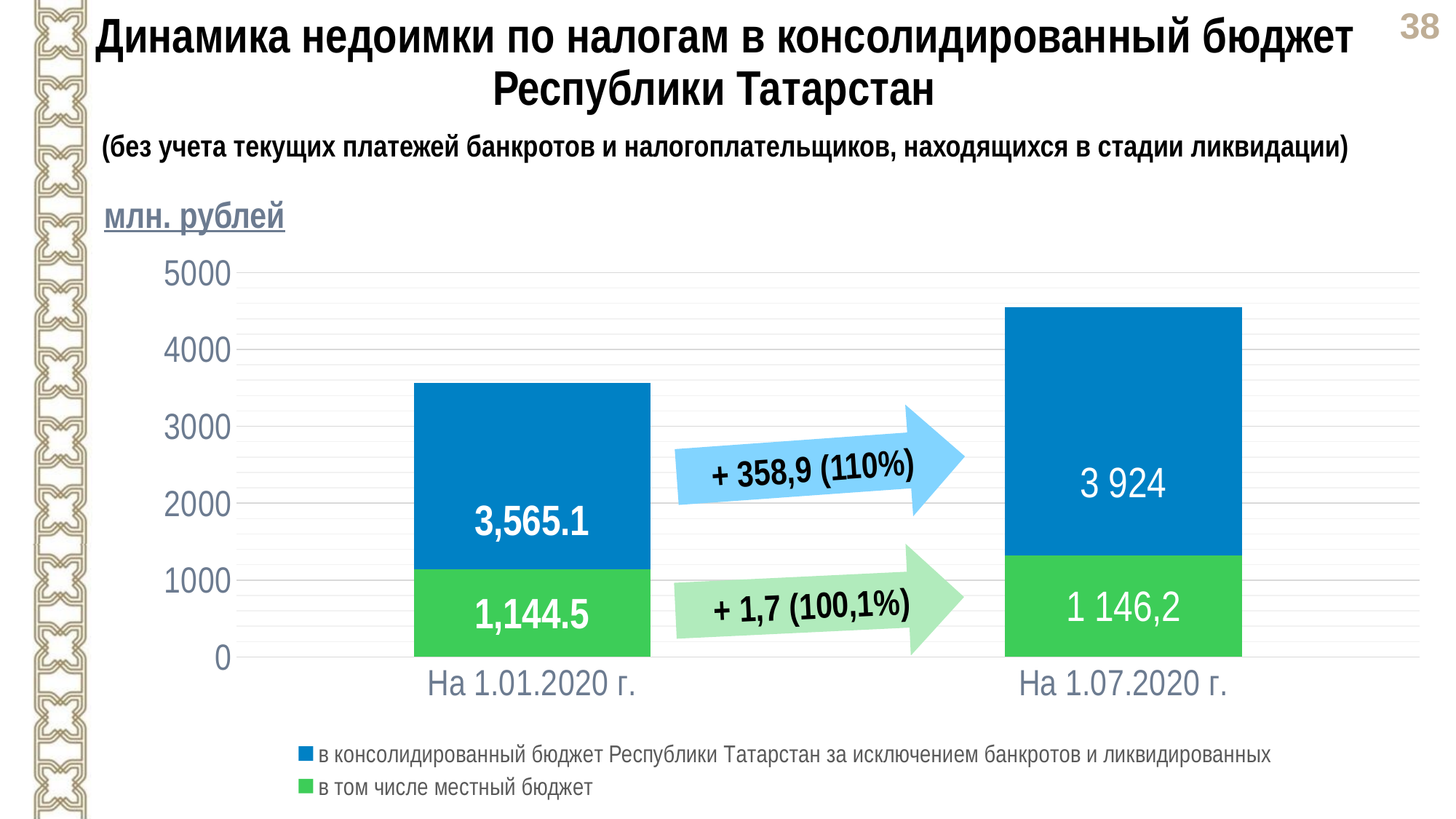
By how much did the local budget series (green) change from На 1.01.2020 г. to На 1.07.2020 г., according to the arrow label? + 1,7 (100,1%) By how much did the consolidated budget series (blue) change from На 1.01.2020 г. to На 1.07.2020 г., according to the arrow label? + 358,9 (110%) What is the value of the local budget series (green) for На 1.07.2020 г.? 1 146,2 What is the value of the local budget series (green) for На 1.01.2020 г.? 1,144.5 How many series does the legend list? 2 For На 1.01.2020 г., which series has the larger value: the consolidated budget (blue) or the local budget (green)? the consolidated budget (blue) What is the value of the consolidated budget series (blue) for На 1.01.2020 г.? 3,565.1 Which date has the higher value for the consolidated budget series (blue): На 1.01.2020 г. or На 1.07.2020 г.? На 1.07.2020 г. What unit of measurement is stated above the chart? млн. рублей What is the value of the consolidated budget series (blue) for На 1.07.2020 г.? 3 924 What kind of chart is shown on the slide? stacked bar chart How many dates (categories) are shown on the x axis? 2